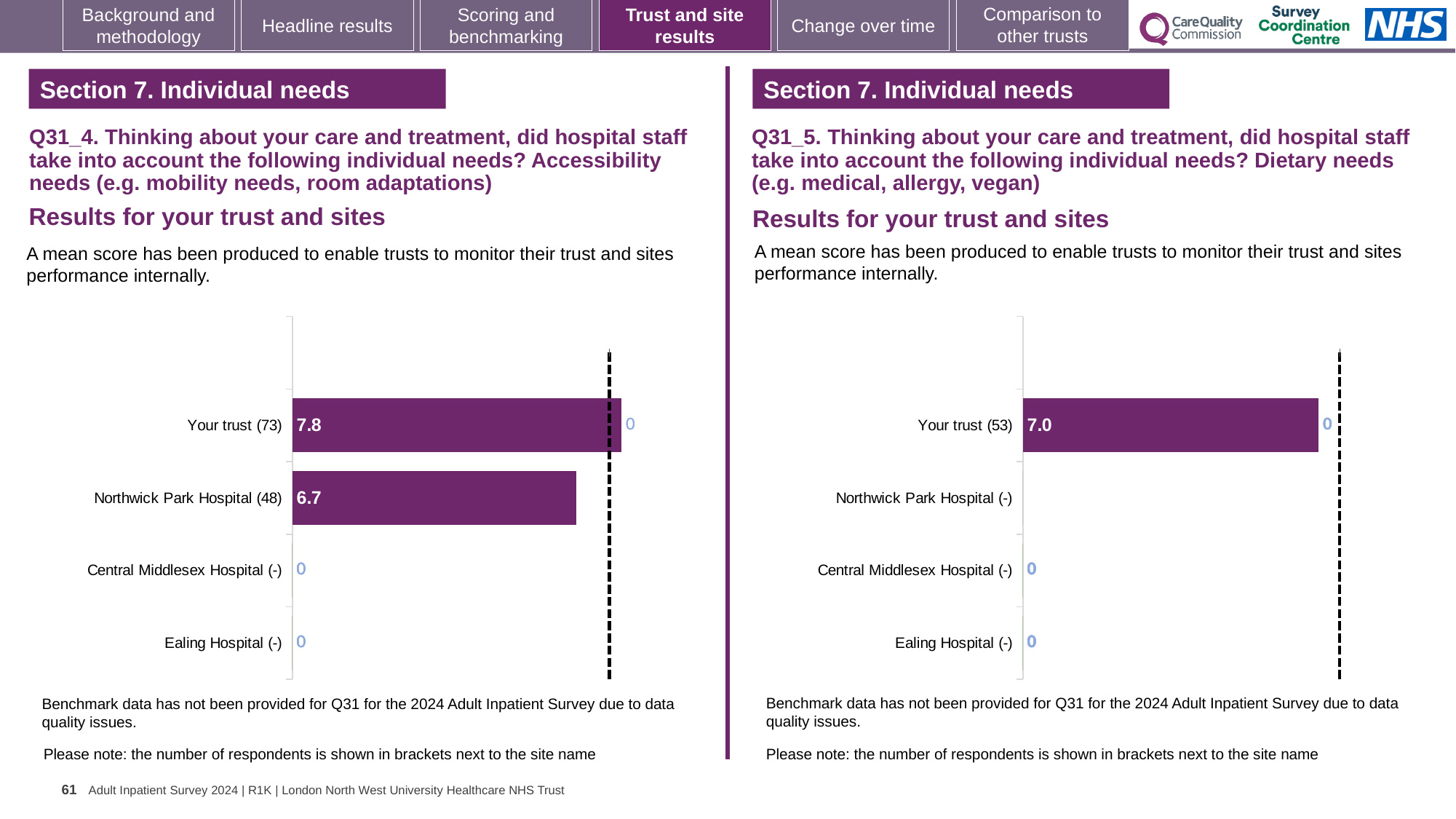
What type of chart is used for the Q31_5 Dietary needs results (right)? Bar chart How many categories are listed on the Q31_4 Accessibility needs chart (left)? 4 On the Q31_4 Accessibility needs chart (left), what is the mean score for Your trust (73)? 7.8 How many categories are listed on the Q31_5 Dietary needs chart (right)? 4 On the Q31_5 Dietary needs chart (right), what is the mean score for Your trust (53)? 7.0 On the Q31_4 Accessibility needs chart (left), how many respondents are shown in brackets for Northwick Park Hospital? 48 On the Q31_4 Accessibility needs chart (left), what is the difference between the scores for Your trust and Northwick Park Hospital? 1.1 On the Q31_5 Dietary needs chart (right), how many respondents are shown in brackets for Your trust? 53 On the Q31_4 Accessibility needs chart (left), which has the higher score, Your trust or Northwick Park Hospital? Your trust Which chart has the higher score for Your trust, the Q31_4 Accessibility needs chart or the Q31_5 Dietary needs chart? Q31_4 Accessibility needs chart On the Q31_4 Accessibility needs chart (left), which category has the highest score? Your trust (73) On the Q31_4 Accessibility needs chart (left), what is the mean score for Northwick Park Hospital (48)? 6.7